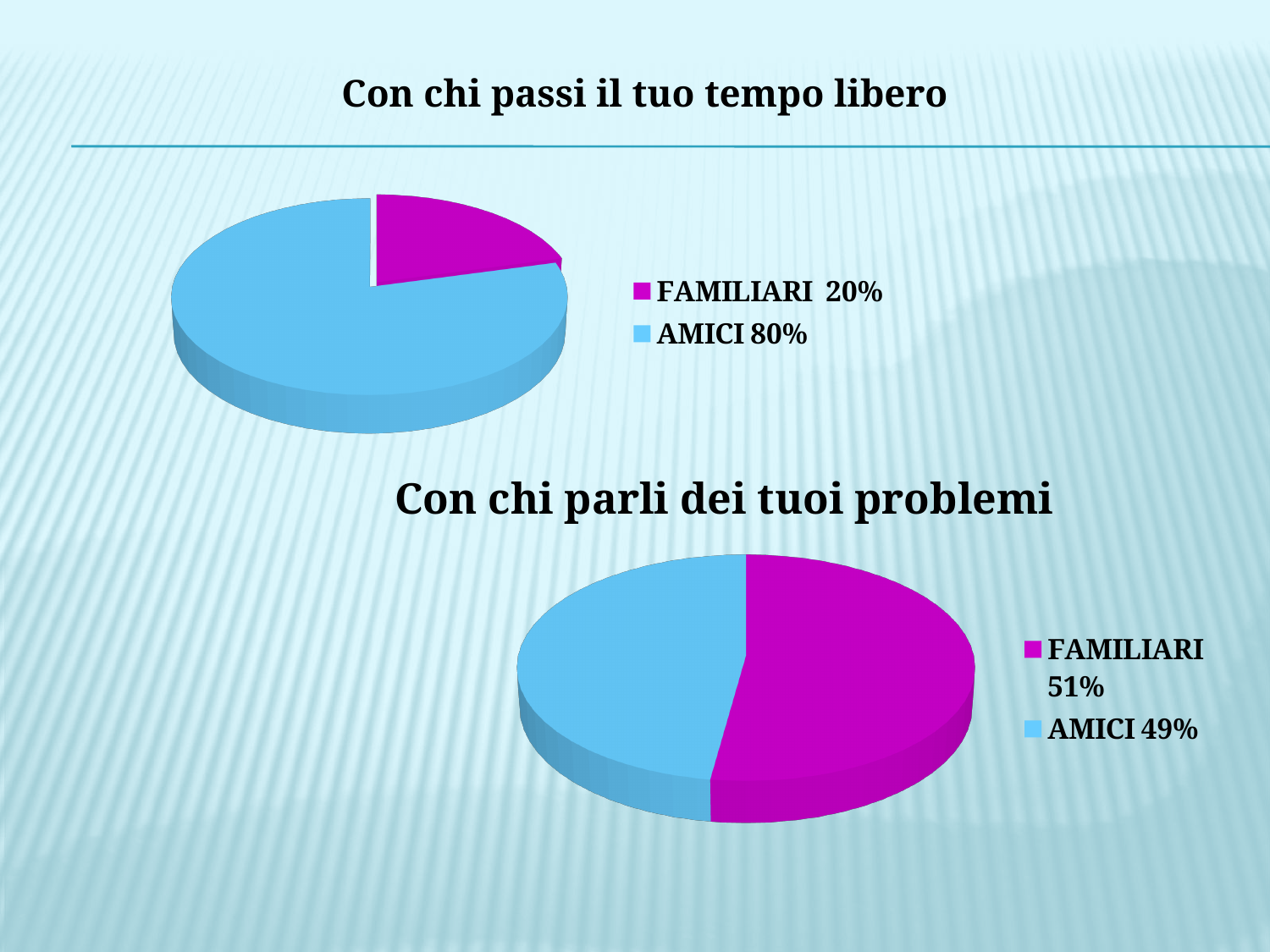
What type of chart is used for "Con chi passi il tuo tempo libero"? Pie chart In the chart titled "Con chi parli dei tuoi problemi", which category has the smallest slice? AMICI How many categories does the chart titled "Con chi parli dei tuoi problemi" show? 2 In the chart titled "Con chi parli dei tuoi problemi", what is the difference between the FAMILIARI and AMICI shares? 2% In the chart titled "Con chi parli dei tuoi problemi", which is larger, FAMILIARI or AMICI? FAMILIARI In the chart titled "Con chi passi il tuo tempo libero", which category has the largest slice? AMICI In the chart titled "Con chi passi il tuo tempo libero", what share is shown for FAMILIARI? 20% In the chart titled "Con chi parli dei tuoi problemi", what share is shown for AMICI? 49% In the chart titled "Con chi passi il tuo tempo libero", what is the difference between the AMICI and FAMILIARI shares? 60% In the chart titled "Con chi passi il tuo tempo libero", what share is shown for AMICI? 80% In the chart titled "Con chi parli dei tuoi problemi", what share is shown for FAMILIARI? 51% In the chart titled "Con chi passi il tuo tempo libero", what colour is the FAMILIARI slice? Magenta